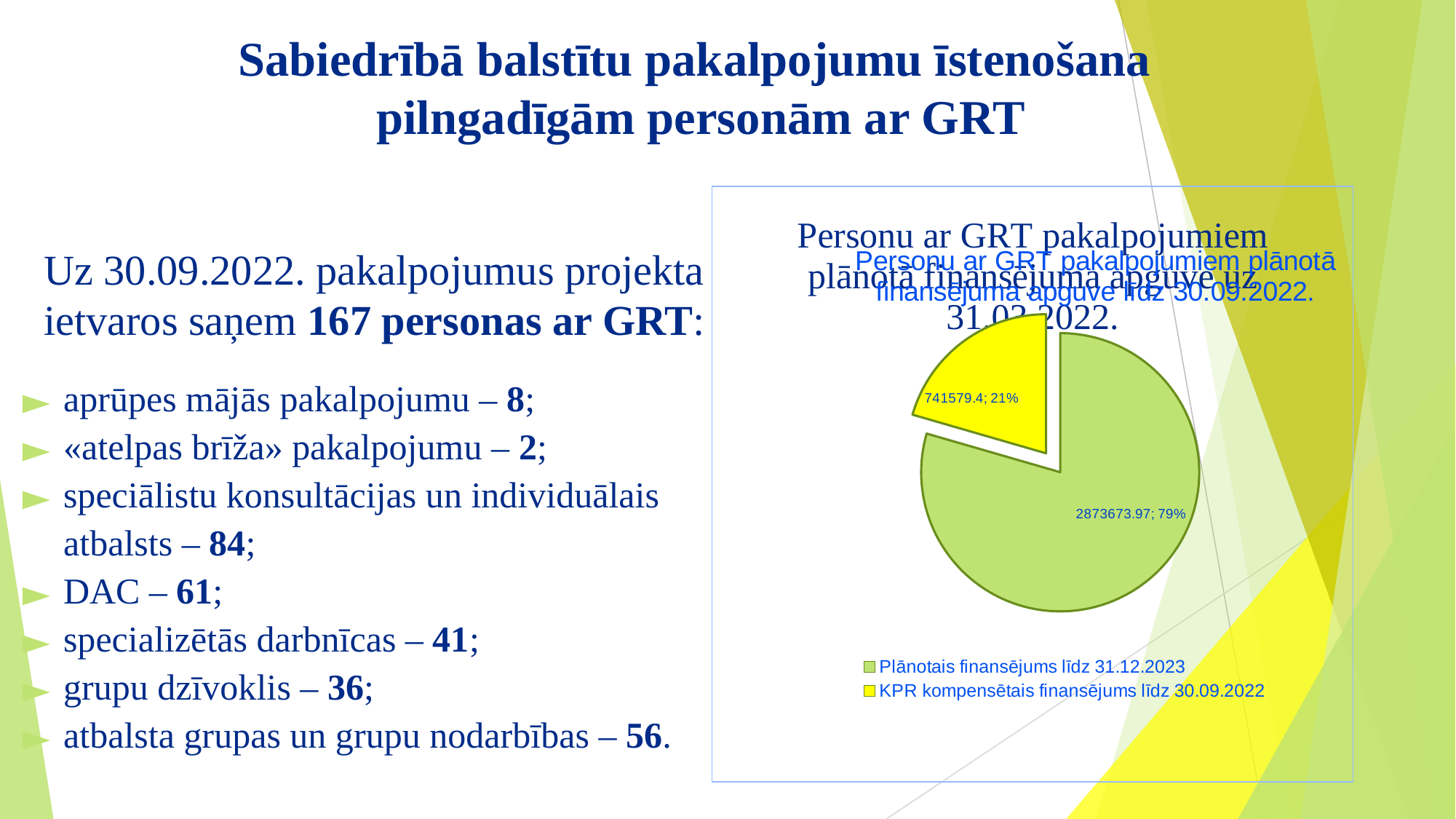
How many slices does the pie chart have? 2 What colour is the slice for "Plānotais finansējums līdz 31.12.2023" in the pie chart? green What share of the pie does "Plānotais finansējums līdz 31.12.2023" represent? 79% What colour is the slice for "KPR kompensētais finansējums līdz 30.09.2022" in the pie chart? yellow Which slice of the pie chart is the smallest? KPR kompensētais finansējums līdz 30.09.2022 Which slice of the pie chart is the largest? Plānotais finansējums līdz 31.12.2023 Which is larger in the pie chart: "Plānotais finansējums līdz 31.12.2023" or "KPR kompensētais finansējums līdz 30.09.2022"? Plānotais finansējums līdz 31.12.2023 What value is shown for "KPR kompensētais finansējums līdz 30.09.2022" in the pie chart? 741579.4 What value is shown for "Plānotais finansējums līdz 31.12.2023" in the pie chart? 2873673.97 What share of the pie does "KPR kompensētais finansējums līdz 30.09.2022" represent? 21% What kind of chart is shown on the slide? pie chart How many entries does the legend of the pie chart list? 2